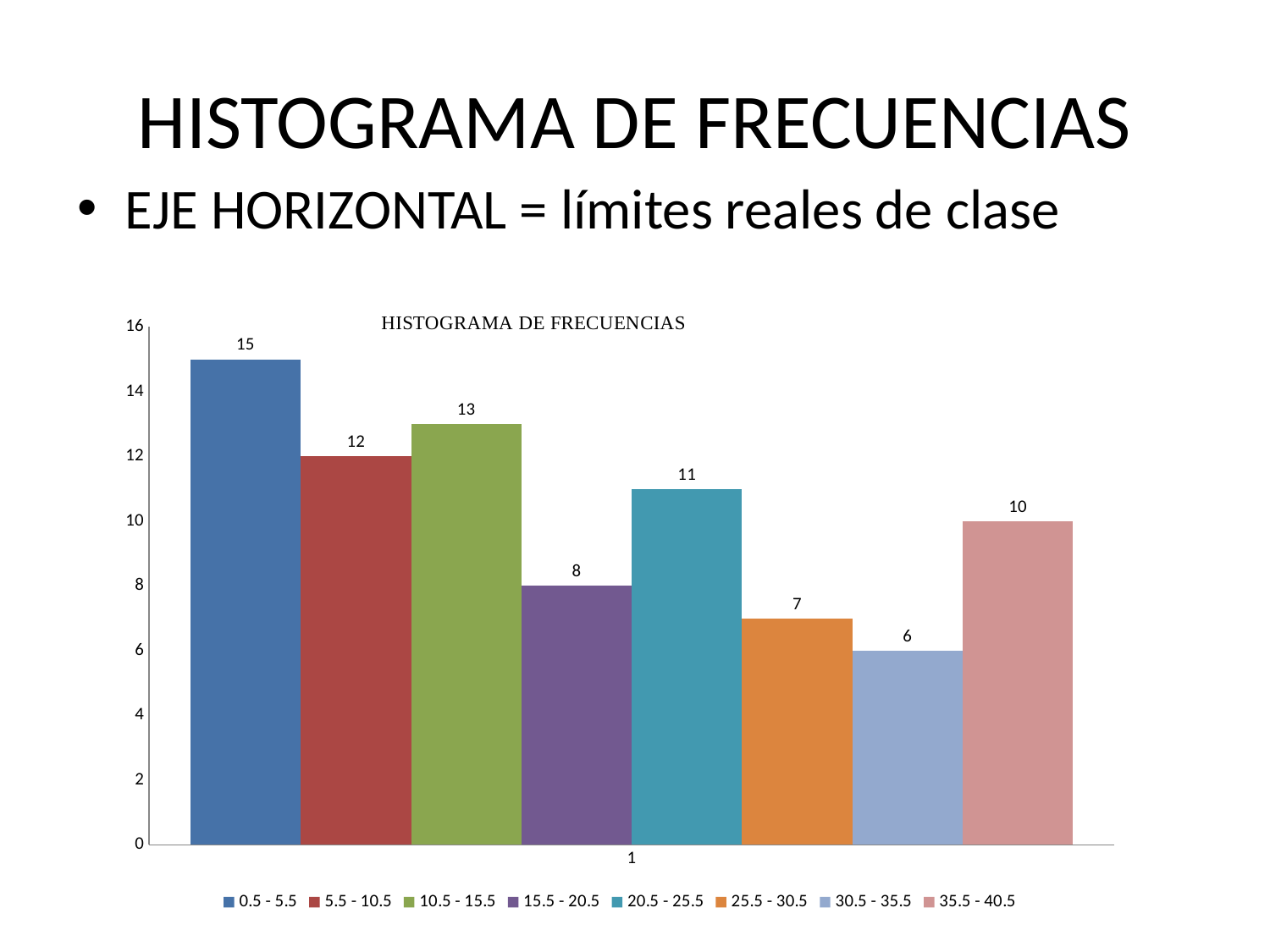
What is the value for the 0.5 - 5.5 class? 15 Which is larger, the value for 5.5 - 10.5 or the value for 20.5 - 25.5? 5.5 - 10.5 What kind of chart is shown on the slide? bar chart Which class has the lowest frequency? 30.5 - 35.5 How many entries does the legend list? 8 What is the value for the 35.5 - 40.5 class? 10 What is the value for the 25.5 - 30.5 class? 7 Which class has the highest frequency? 0.5 - 5.5 Is the value for 20.5 - 25.5 greater or less than 10? greater What is the title of the chart? HISTOGRAMA DE FRECUENCIAS What is the difference between the values for 10.5 - 15.5 and 15.5 - 20.5? 5 How many bars are shown in the chart? 8